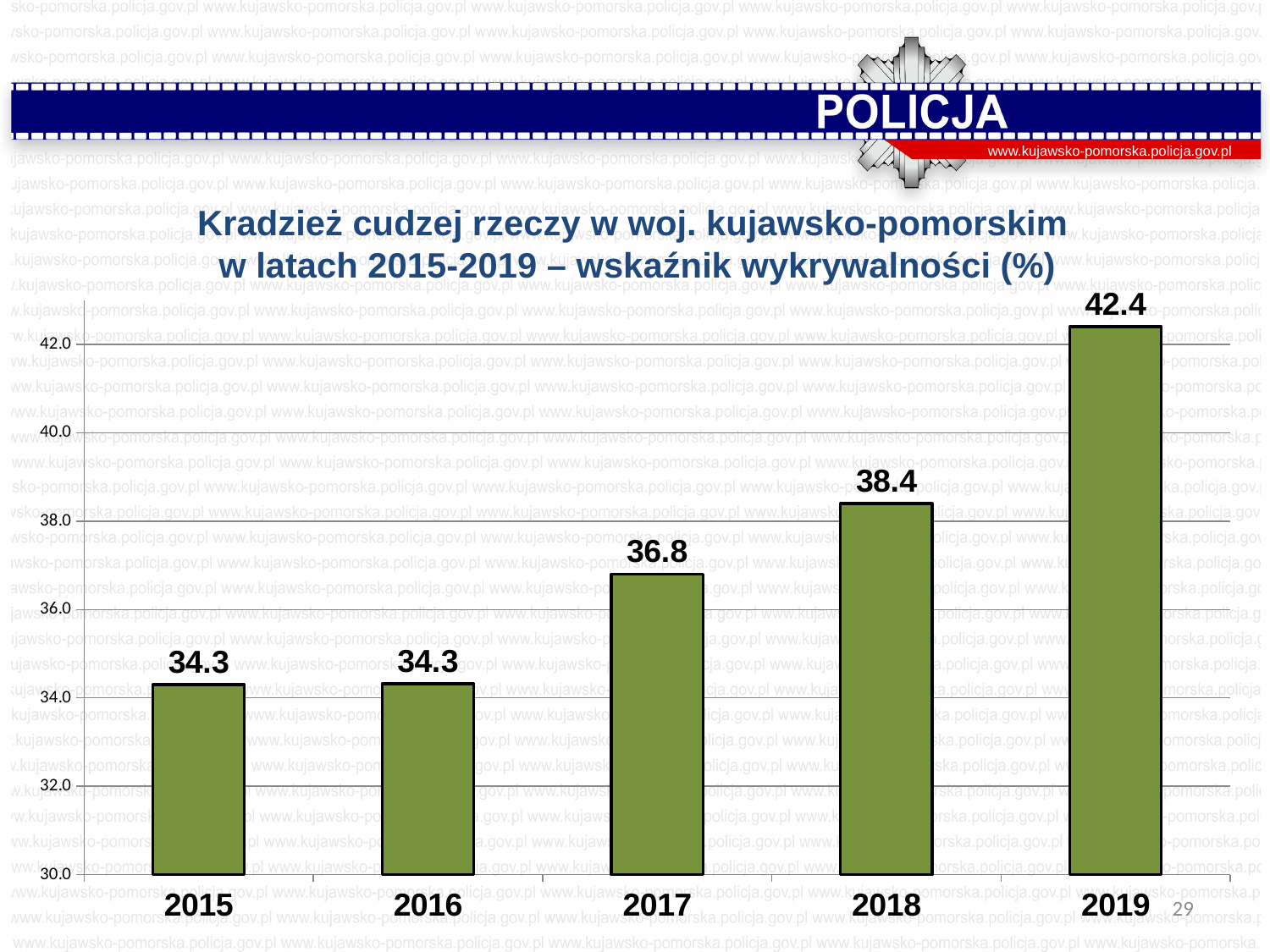
Which is larger, the value for 2017 or the value for 2018? 2018 How many years are shown on the chart? 5 Do the values rise or fall from 2016 to 2019? rise Which year has the highest value? 2019 What is the value shown for 2017? 36.8 What is the detection rate value for 2019? 42.4 Is the value for 2016 greater or less than 36.0? less Which two years have the same value? 2015 and 2016 What is the difference between the values for 2017 and 2016? 2.5 What is the value shown for 2018? 38.4 What kind of chart is shown on the slide? bar chart What is the difference between the values for 2019 and 2018? 4.0